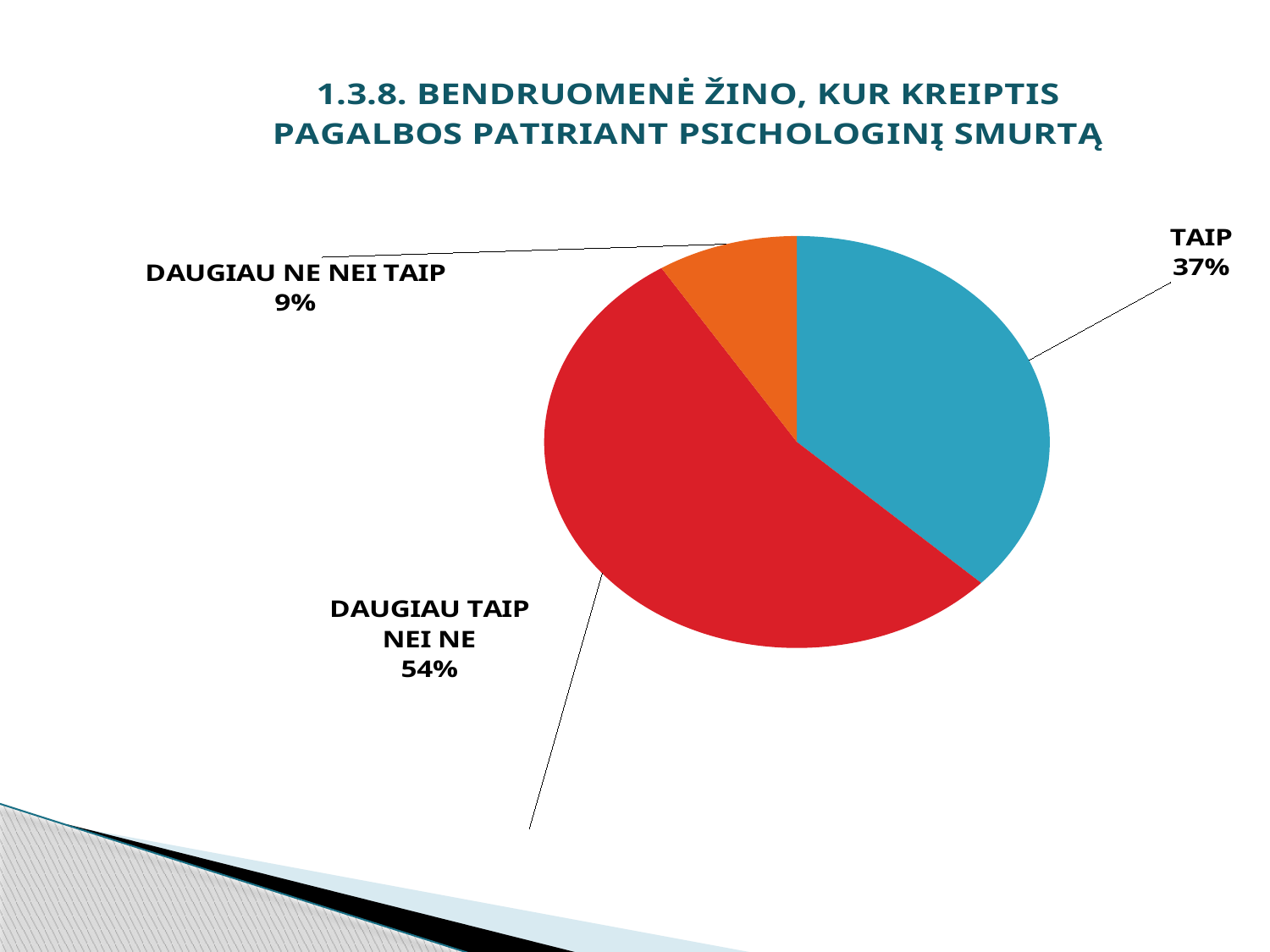
How many slices does the pie chart have? 3 What is the value for DAUGIAU NE NEI TAIP? 9% What is the difference between TAIP and DAUGIAU NE NEI TAIP? 28% What is the difference between DAUGIAU TAIP NEI NE and TAIP? 17% What kind of chart is shown on the slide? pie chart What share of the pie does DAUGIAU TAIP NEI NE have? 54% Which category has the largest slice? DAUGIAU TAIP NEI NE Which category has the smallest slice? DAUGIAU NE NEI TAIP What colour is the slice for DAUGIAU TAIP NEI NE? red Which is larger, TAIP or DAUGIAU NE NEI TAIP? TAIP What is the title of the slide? 1.3.8. BENDRUOMENĖ ŽINO, KUR KREIPTIS PAGALBOS PATIRIANT PSICHOLOGINĮ SMURTĄ What is the value for TAIP? 37%